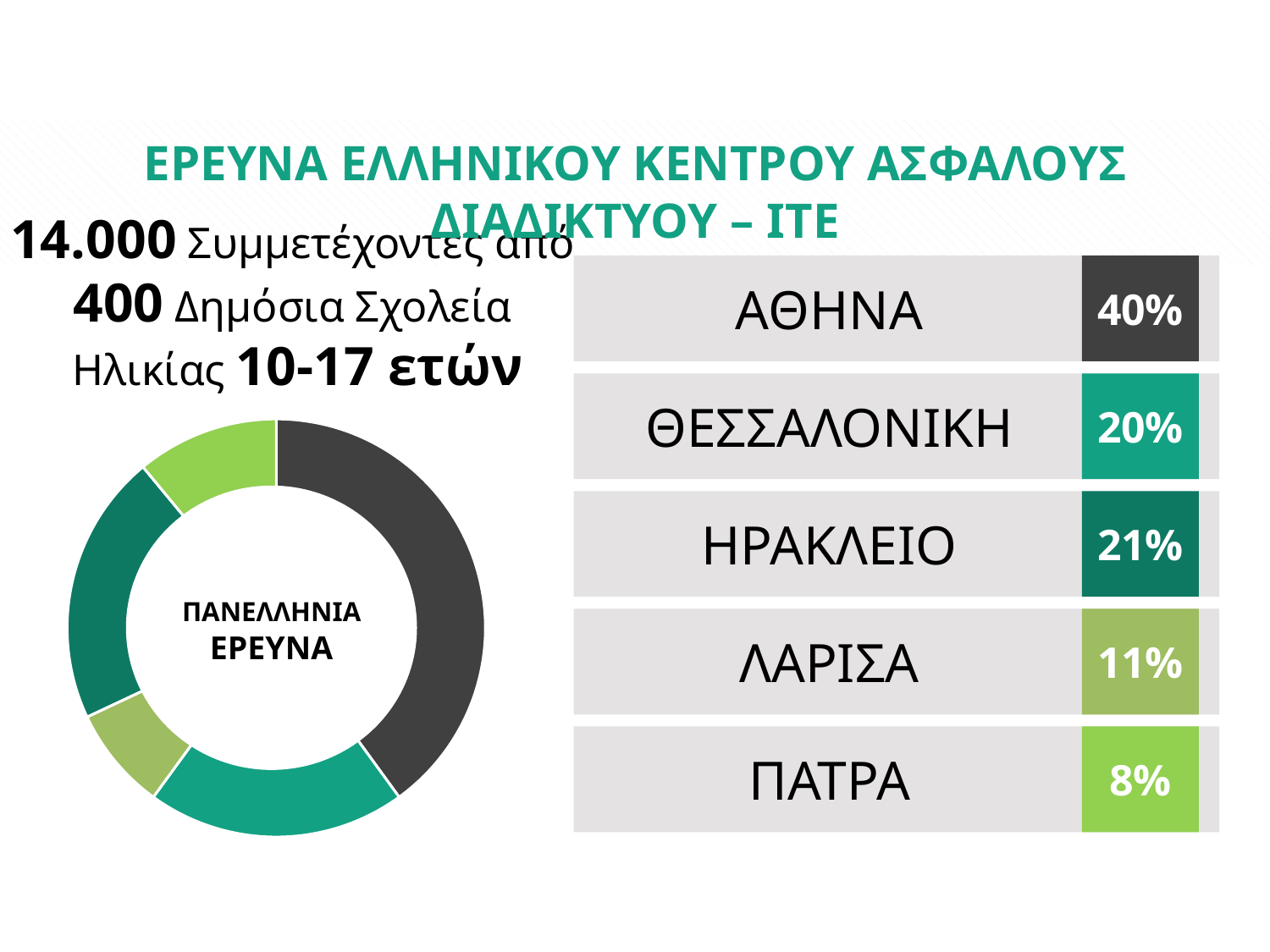
What kind of chart is shown on the slide? Donut (pie) chart What percentage is shown for ΗΡΑΚΛΕΙΟ? 21% Which has the larger share, ΗΡΑΚΛΕΙΟ or ΘΕΣΣΑΛΟΝΙΚΗ? ΗΡΑΚΛΕΙΟ What is the difference in percentage points between ΑΘΗΝΑ and ΘΕΣΣΑΛΟΝΙΚΗ? 20 Which city has the smallest share in the chart? ΠΑΤΡΑ What percentage is shown for ΛΑΡΙΣΑ? 11% What percentage is shown for ΠΑΤΡΑ? 8% What percentage is shown for ΑΘΗΝΑ? 40% What percentage is shown for ΘΕΣΣΑΛΟΝΙΚΗ? 20% How many cities are shown in the chart? 5 What text appears in the centre of the donut chart? ΠΑΝΕΛΛΗΝΙΑ ΕΡΕΥΝΑ Which city has the largest share in the chart? ΑΘΗΝΑ